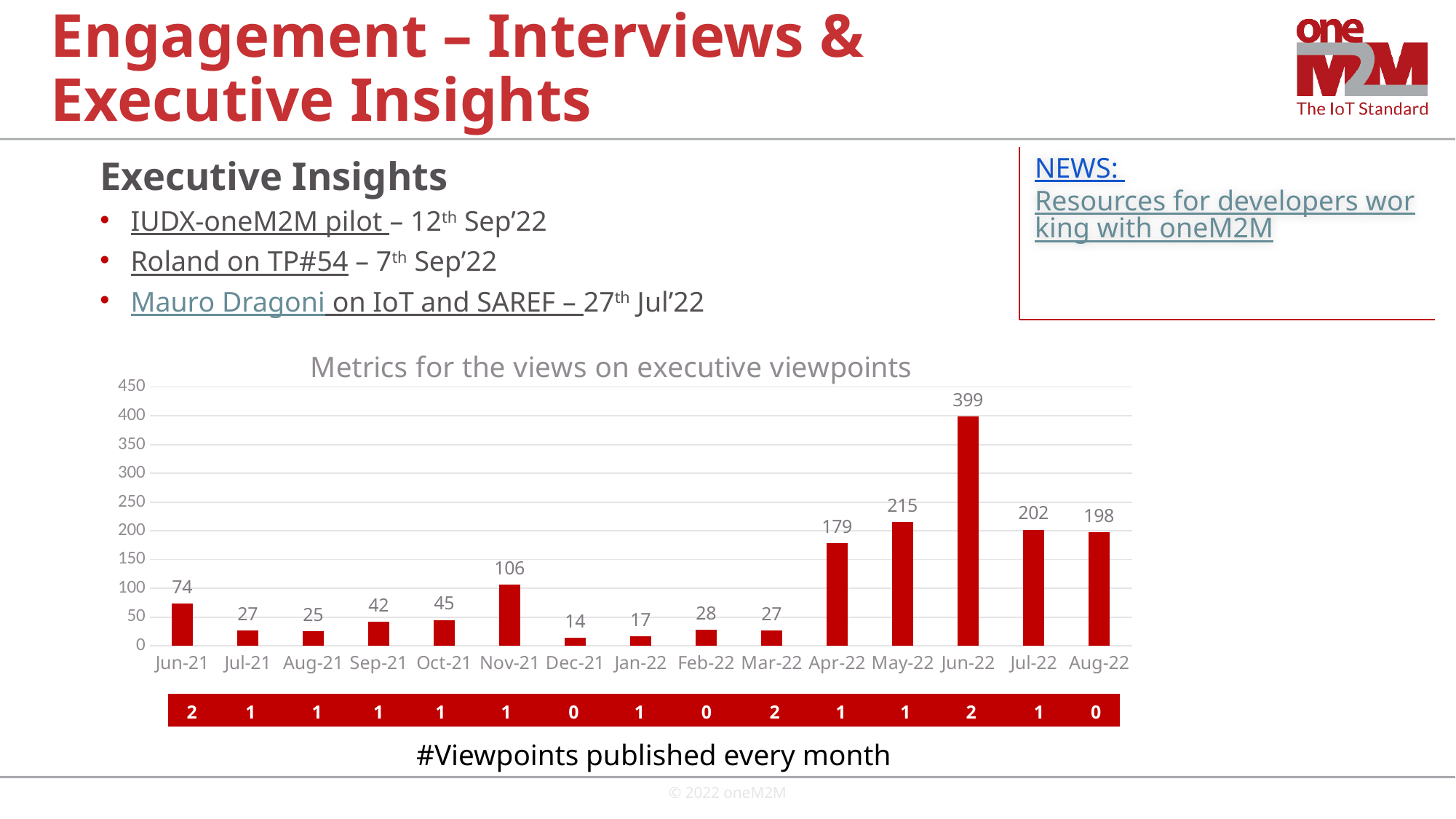
Which month has the highest value in the chart? Jun-22 What is the value for Nov-21 in the chart? 106 How many months are shown on the x axis of the chart? 15 What is the value for Jun-22 in the chart? 399 Which month has the lowest value in the chart? Dec-21 What is the value for Apr-22 in the chart? 179 What is the difference between the values for Jun-22 and May-22? 184 What kind of chart is shown on the slide? bar chart Which is larger, the value for Jun-21 or the value for Oct-21? Jun-21 What is the title of the chart? Metrics for the views on executive viewpoints What is the difference between the values for Jul-22 and Aug-22? 4 Is the value for May-22 greater or less than 200? greater